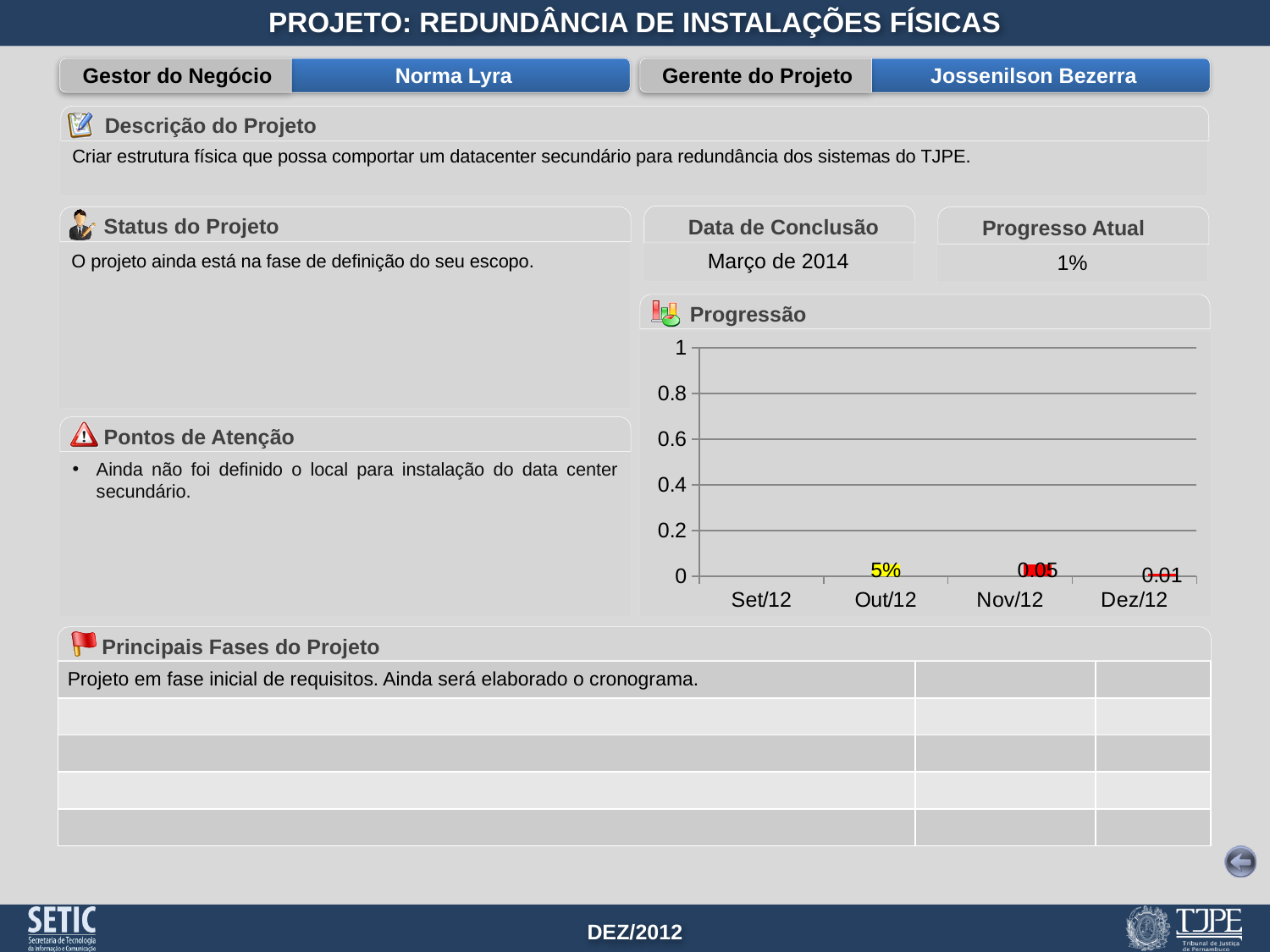
What is the highest value shown on the y axis of the Progressão chart? 1 In the Progressão chart, is the value for Dez/12 greater or less than 0.2? less In the Progressão chart, is the value for Nov/12 greater or less than 0.4? less What is the data label shown for Dez/12 in the Progressão chart? 0.01 What is the title of the chart on the slide? Progressão What is the first category on the x axis of the Progressão chart? Set/12 What is the data label shown for Out/12 in the Progressão chart? 5% How many categories are shown on the x axis of the Progressão chart? 4 In the Progressão chart, is the value for Out/12 greater or less than 0.2? less